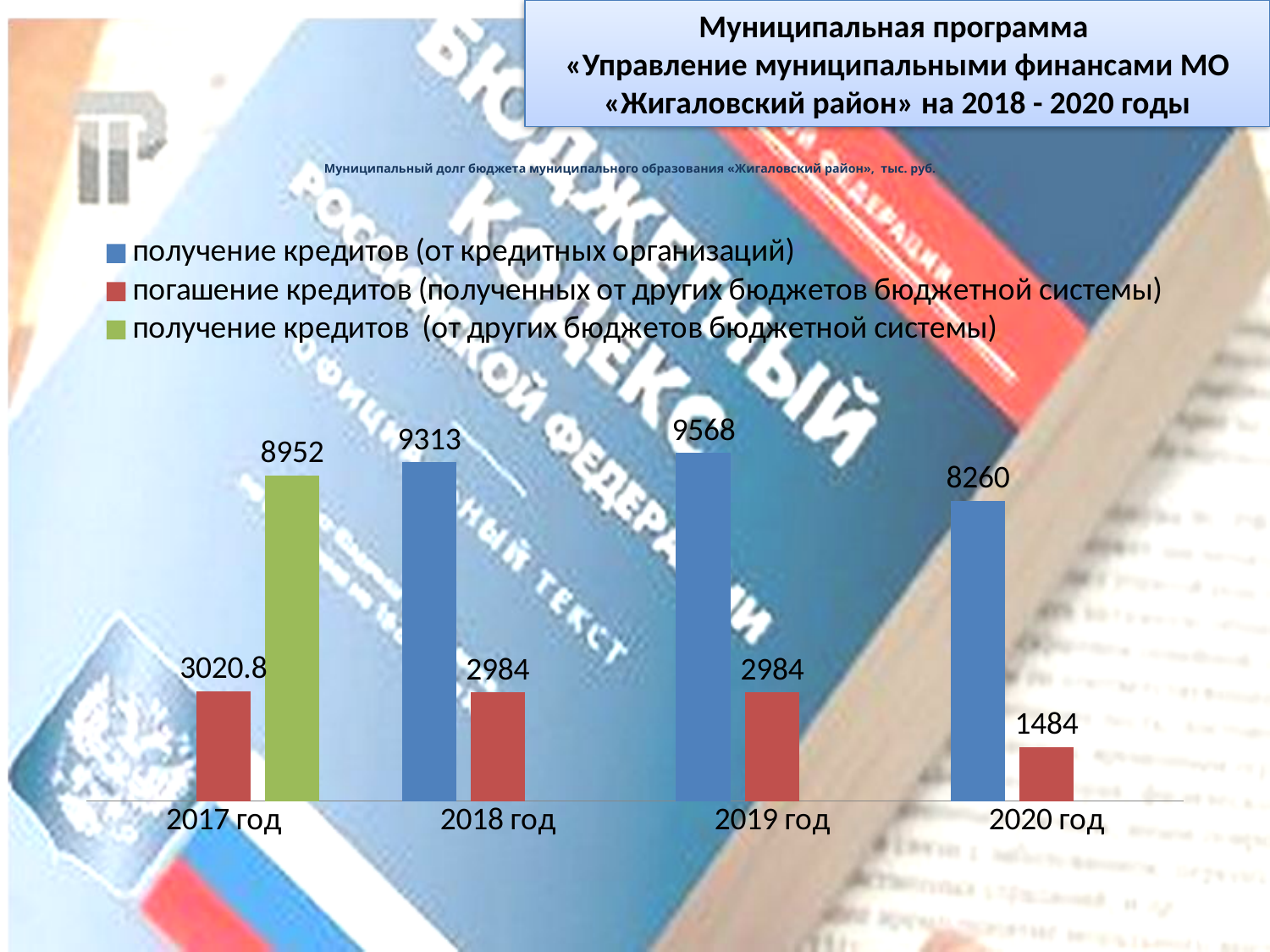
What is the difference between the «получение кредитов (от кредитных организаций)» values for 2019 год and 2020 год? 1308 Which is larger: «получение кредитов (от кредитных организаций)» in 2018 год or in 2020 год? 2018 год How many year categories are shown on the x axis of the chart? 4 What type of chart is shown on the slide? bar chart In which year is the value of «погашение кредитов (полученных от других бюджетов бюджетной системы)» the lowest? 2020 год In which year is the value of «получение кредитов (от кредитных организаций)» the highest? 2019 год What is the value of «погашение кредитов (полученных от других бюджетов бюджетной системы)» for 2020 год? 1484 What unit is stated in the chart title? тыс. руб. What is the value of «получение кредитов (от других бюджетов бюджетной системы)» for 2017 год? 8952 What is the value of «получение кредитов (от кредитных организаций)» for 2019 год? 9568 What is the value of «погашение кредитов (полученных от других бюджетов бюджетной системы)» for 2017 год? 3020.8 How many series does the chart legend list? 3